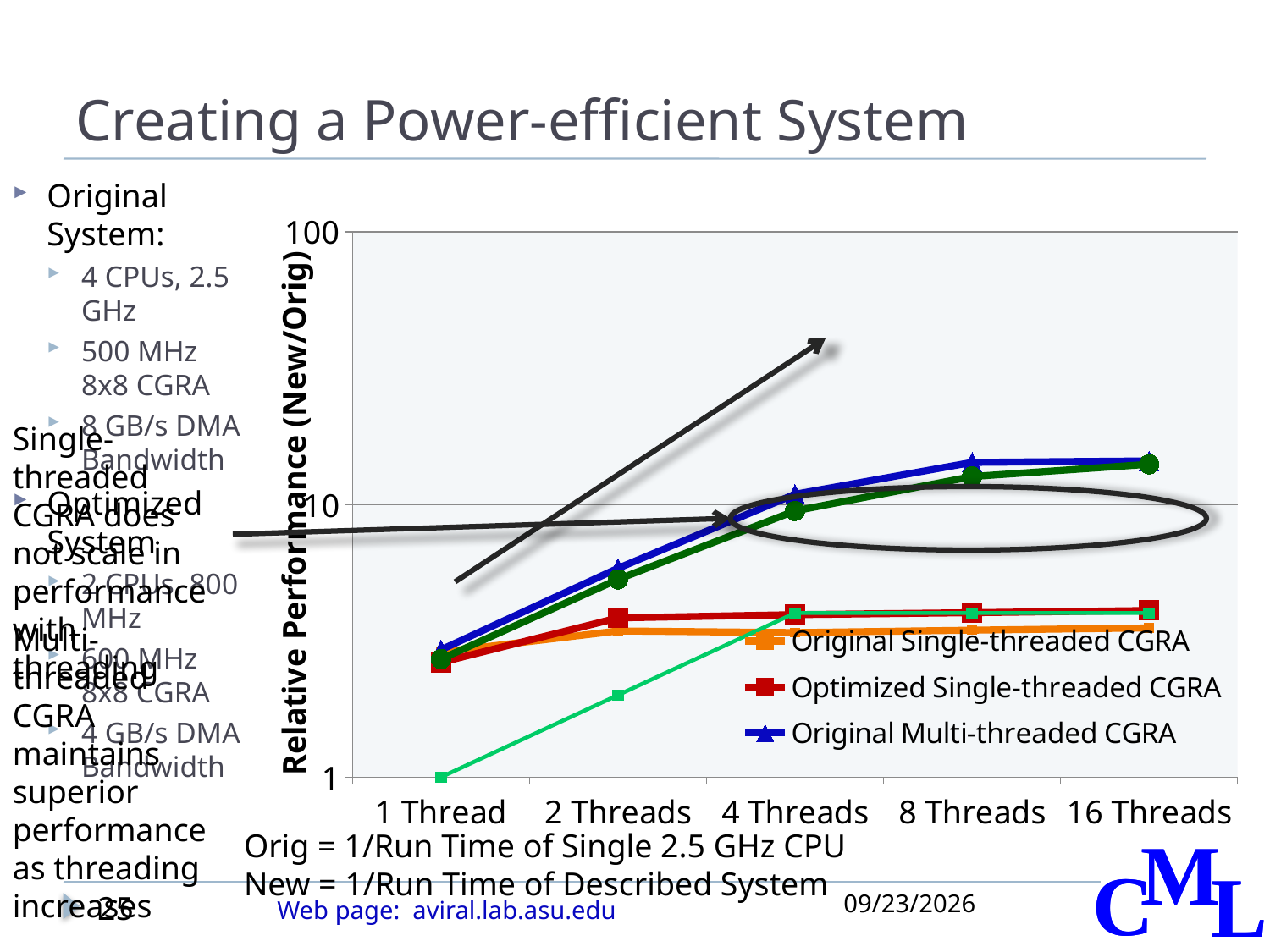
Which legend series has the highest value at 16 Threads? Original Multi-threaded CGRA What is the label of the y axis? Relative Performance (New/Orig) Is the value for Original Multi-threaded CGRA at 16 Threads greater or less than 10? greater How many series does the chart legend list? 3 Does the Original Multi-threaded CGRA series rise or fall as the number of threads increases? rise What kind of chart is shown on the slide? line chart Is the value for Optimized Single-threaded CGRA at 1 Thread greater or less than 10? less Is the value for Original Multi-threaded CGRA at 1 Thread greater or less than 10? less How many thread-count categories are shown on the x axis? 5 At 4 Threads, which is larger: Original Multi-threaded CGRA or Optimized Single-threaded CGRA? Original Multi-threaded CGRA At 16 Threads, which is larger: Original Multi-threaded CGRA or Original Single-threaded CGRA? Original Multi-threaded CGRA